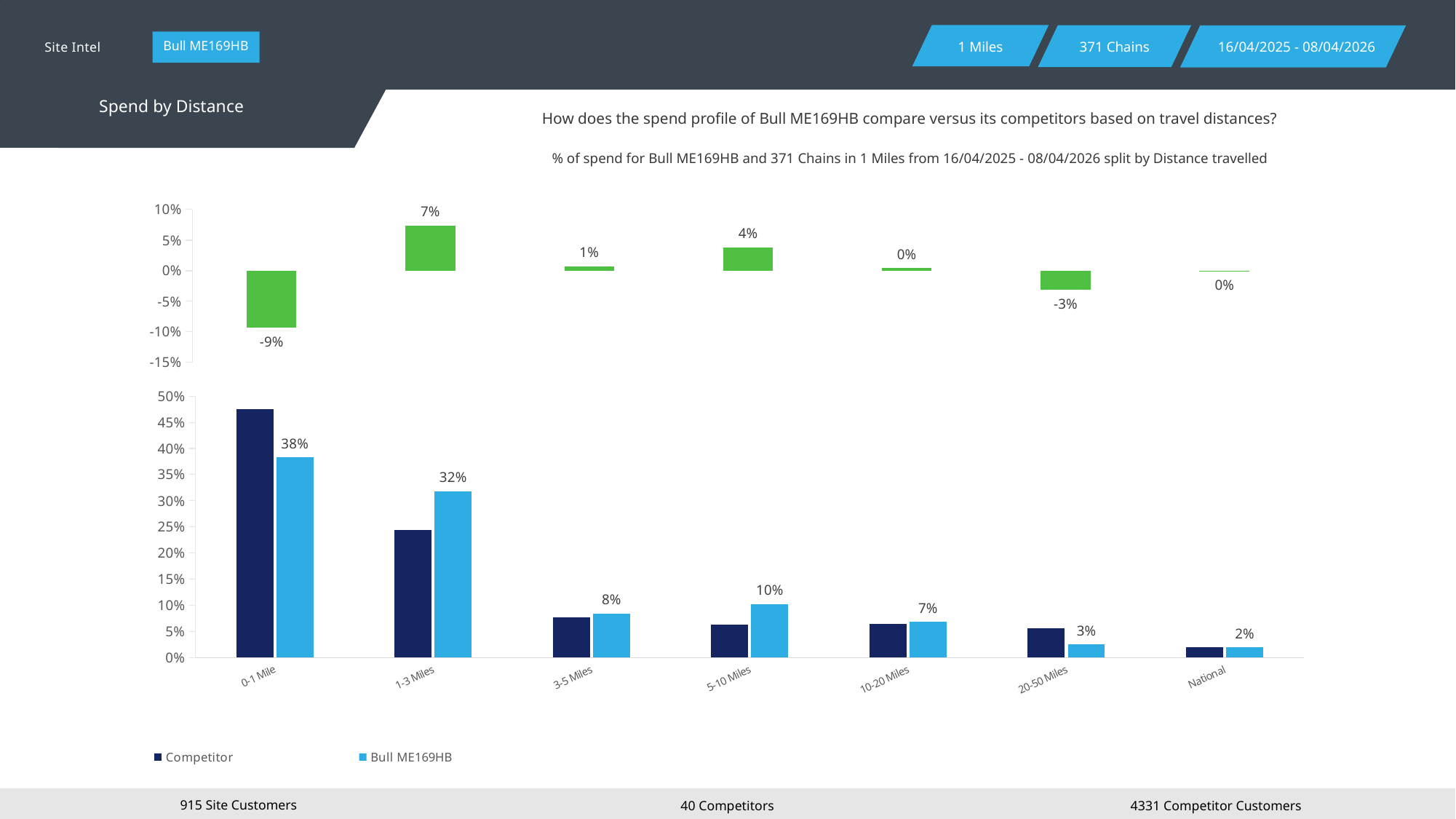
How many distance categories are shown on the x axis of the bottom chart? 7 In the bottom chart, for the 0-1 Mile category, which series has the larger value, Competitor or Bull ME169HB? Competitor In the top chart, what is the value of the leftmost bar? -9% What kind of chart is the bottom chart? bar chart In the top chart, what is the highest value shown? 7% In the bottom chart, what is the value for Bull ME169HB in the 0-1 Mile category? 38% In the bottom chart, what is the value for Bull ME169HB in the 1-3 Miles category? 32% In the bottom chart, is the Competitor value for 0-1 Mile greater or less than 45%? greater In the bottom chart, which category has the lowest value for Bull ME169HB? National In the bottom chart, which category has the highest value for Bull ME169HB? 0-1 Mile How many series does the legend of the bottom chart list? 2 In the bottom chart, what is the difference between the Bull ME169HB values for 0-1 Mile and 1-3 Miles? 6%